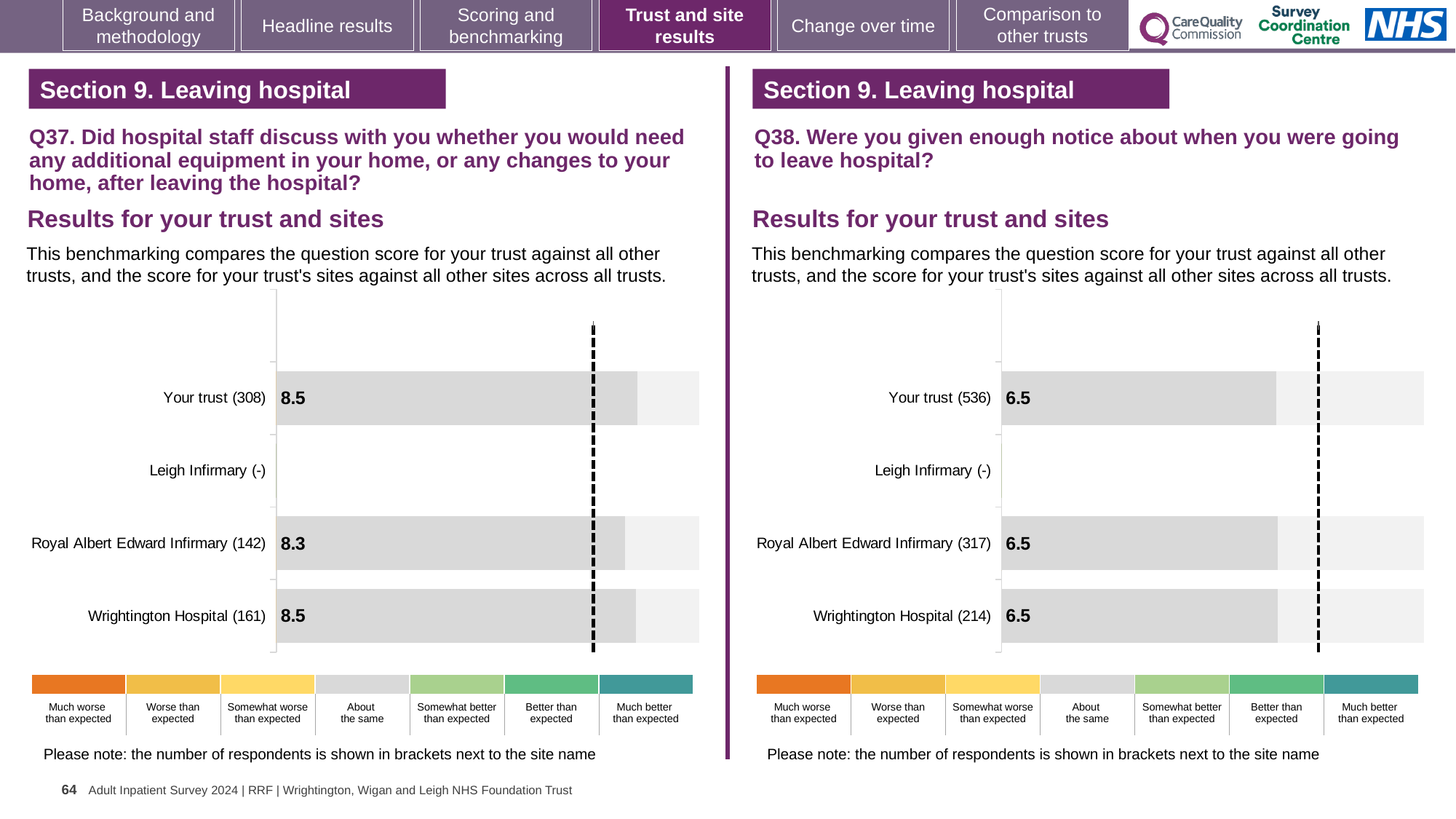
In the Q37 chart on the left, which labelled site has the lowest score? Royal Albert Edward Infirmary In the Q37 chart on the left, what is the score for Your trust? 8.5 In the Q38 chart on the right, what is the score for Your trust? 6.5 In the Q38 chart on the right, how many respondents are shown in brackets for Your trust? 536 In the Q37 chart on the left, which has the higher score, Your trust or Royal Albert Edward Infirmary? Your trust How many categories are listed on the y axis of the Q38 chart on the right? 4 What kind of chart is the Q37 chart on the left? Bar chart In the Q37 chart on the left, what is the difference between the scores for Wrightington Hospital and Royal Albert Edward Infirmary? 0.2 In the Q37 chart on the left, how many respondents are shown in brackets for Royal Albert Edward Infirmary? 142 In the Q37 chart on the left, what is the score for Royal Albert Edward Infirmary? 8.3 In the Q38 chart on the right, what is the score for Wrightington Hospital? 6.5 In the Q37 chart on the left, what is the score for Wrightington Hospital? 8.5